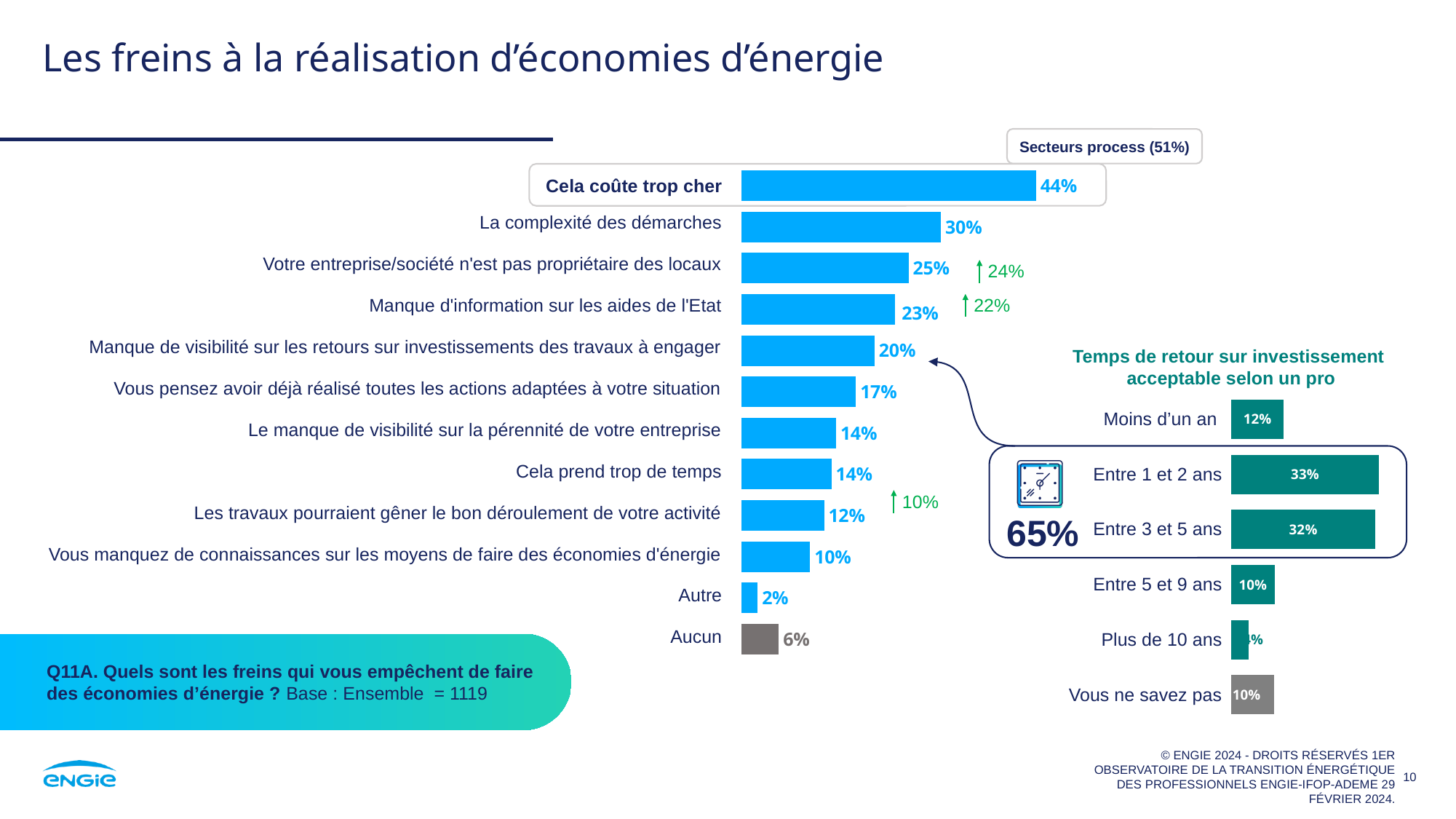
In the main bar chart on the left, which category has the highest value? Cela coûte trop cher In the main bar chart on the left, what is the value for "Cela coûte trop cher"? 44% In the main bar chart on the left, what is the difference between "Cela coûte trop cher" and "La complexité des démarches"? 14% In the main bar chart on the left, which is larger: "Les travaux pourraient gêner le bon déroulement de votre activité" or "Vous manquez de connaissances sur les moyens de faire des économies d'énergie"? Les travaux pourraient gêner le bon déroulement de votre activité In the chart titled "Temps de retour sur investissement acceptable selon un pro", what is the difference between "Entre 1 et 2 ans" and "Moins d'un an"? 21% In the chart titled "Temps de retour sur investissement acceptable selon un pro", which category has the highest value? Entre 1 et 2 ans What type of chart is the main chart on the left? Bar chart In the main bar chart on the left, what is the value for "Manque d'information sur les aides de l'Etat"? 23% In the main bar chart on the left, which category has the lowest value? Autre How many categories are shown in the chart titled "Temps de retour sur investissement acceptable selon un pro"? 6 How many categories are shown in the main bar chart on the left? 12 In the chart titled "Temps de retour sur investissement acceptable selon un pro", what is the value for "Entre 1 et 2 ans"? 33%